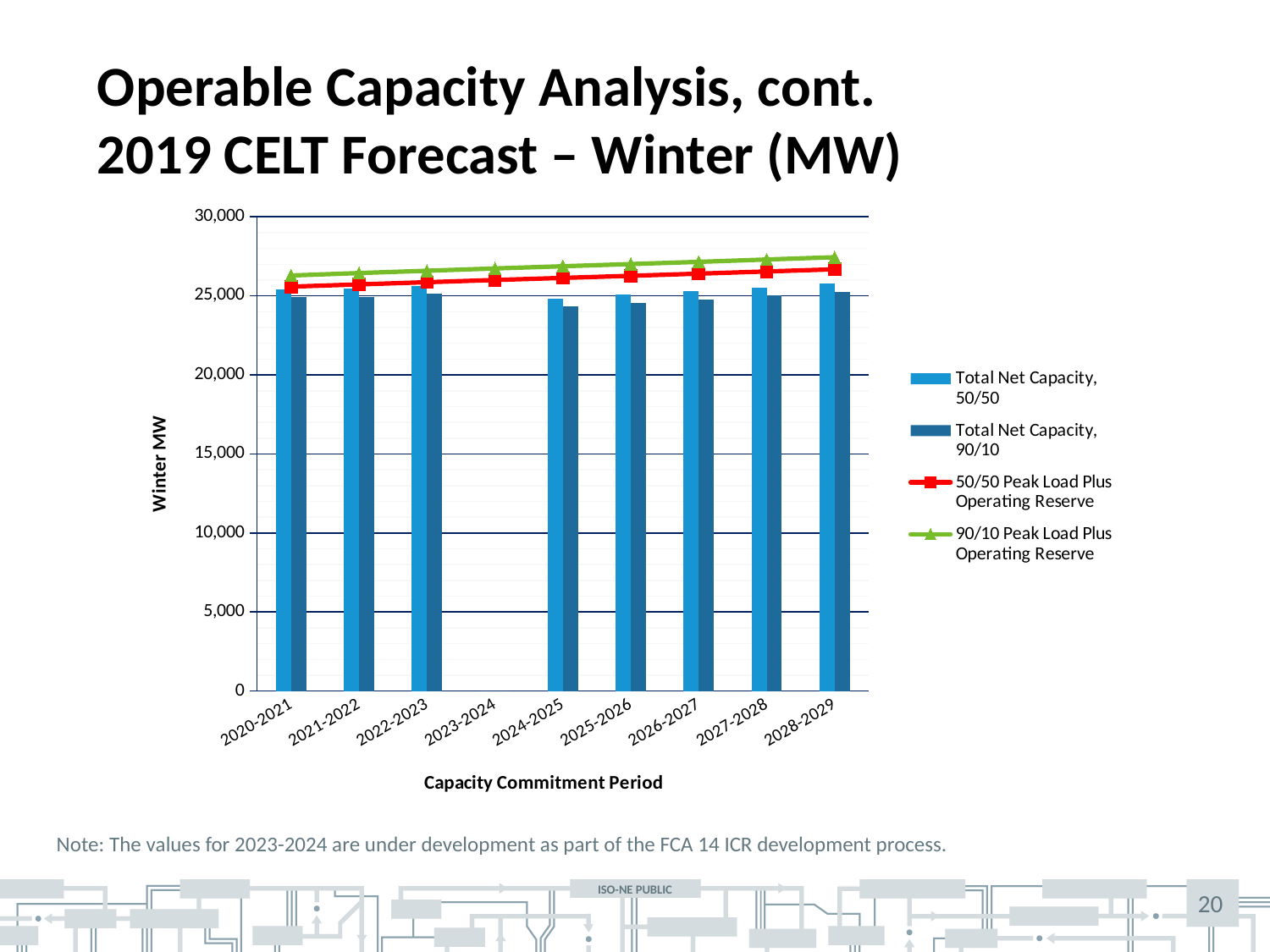
How many series does the legend list? 4 What kind of chart is shown on the slide? Combined bar and line chart What is the label of the y axis? Winter MW For 2020-2021, which is larger: the 90/10 Peak Load Plus Operating Reserve or the 50/50 Peak Load Plus Operating Reserve? 90/10 Peak Load Plus Operating Reserve Does the 90/10 Peak Load Plus Operating Reserve line rise or fall across the capacity commitment periods? Rise Is the Total Net Capacity, 50/50 value for 2020-2021 greater or less than 30,000? less Is the 90/10 Peak Load Plus Operating Reserve value for 2028-2029 greater or less than 25,000? greater Is the Total Net Capacity, 90/10 value for 2024-2025 greater or less than 25,000? less For 2028-2029, which is larger: Total Net Capacity, 50/50 or Total Net Capacity, 90/10? Total Net Capacity, 50/50 How many capacity commitment periods are shown on the x axis? 9 In which capacity commitment period is the 90/10 Peak Load Plus Operating Reserve highest? 2028-2029